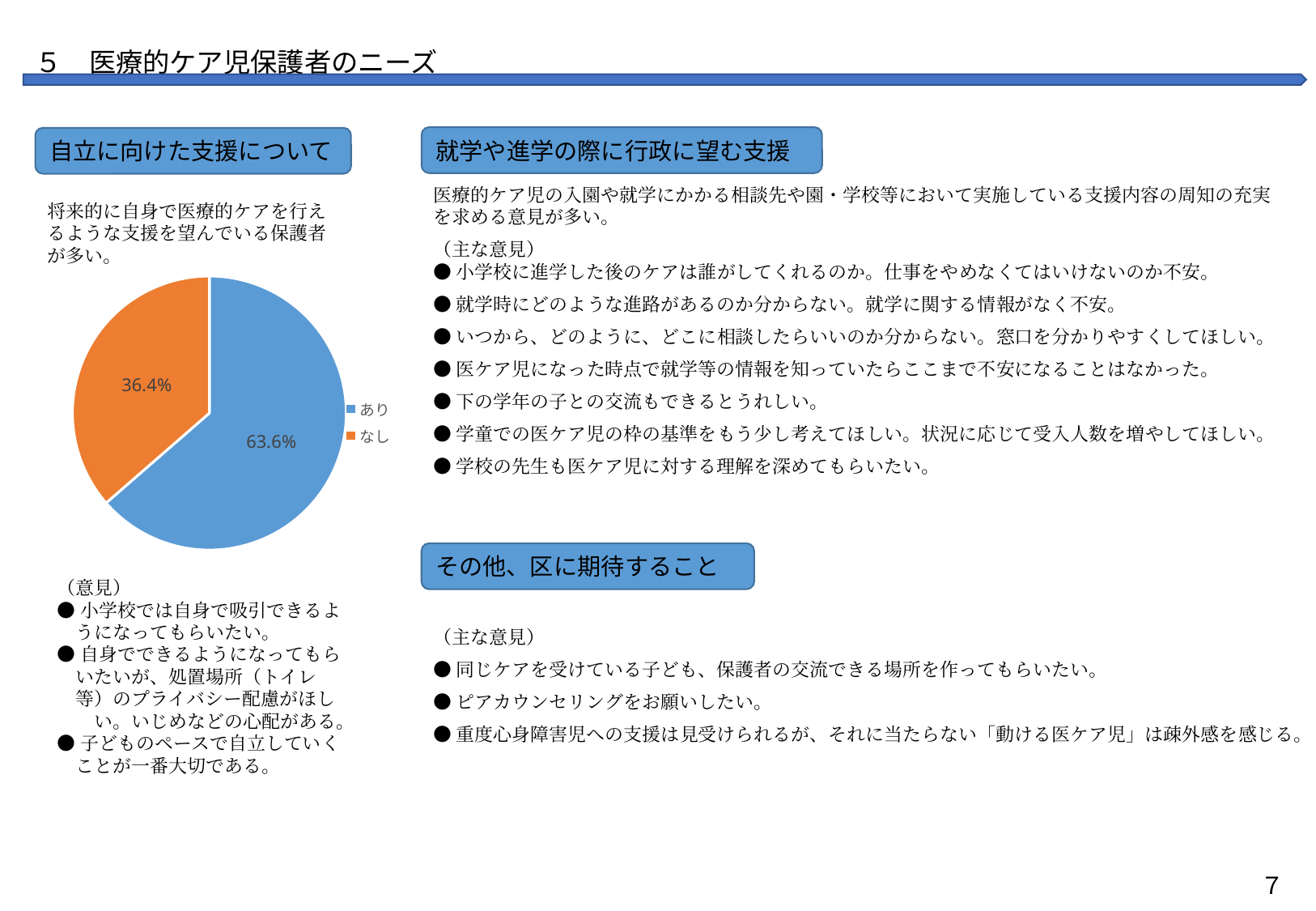
How many slices does the pie chart have? 2 What is the share of the pie taken by the なし slice? 36.4% What percentage does the あり slice of the pie chart represent? 63.6% How many entries does the pie chart's legend list? 2 What colour is the なし slice in the pie chart? orange What colour is the あり slice in the pie chart? blue What percentage does the なし slice of the pie chart represent? 36.4% Which is larger in the pie chart, あり or なし? あり Which category has the smallest share in the pie chart? なし What is the difference in percentage points between the あり and なし slices? 27.2 What kind of chart is shown on the slide? pie chart Which category has the largest share in the pie chart? あり